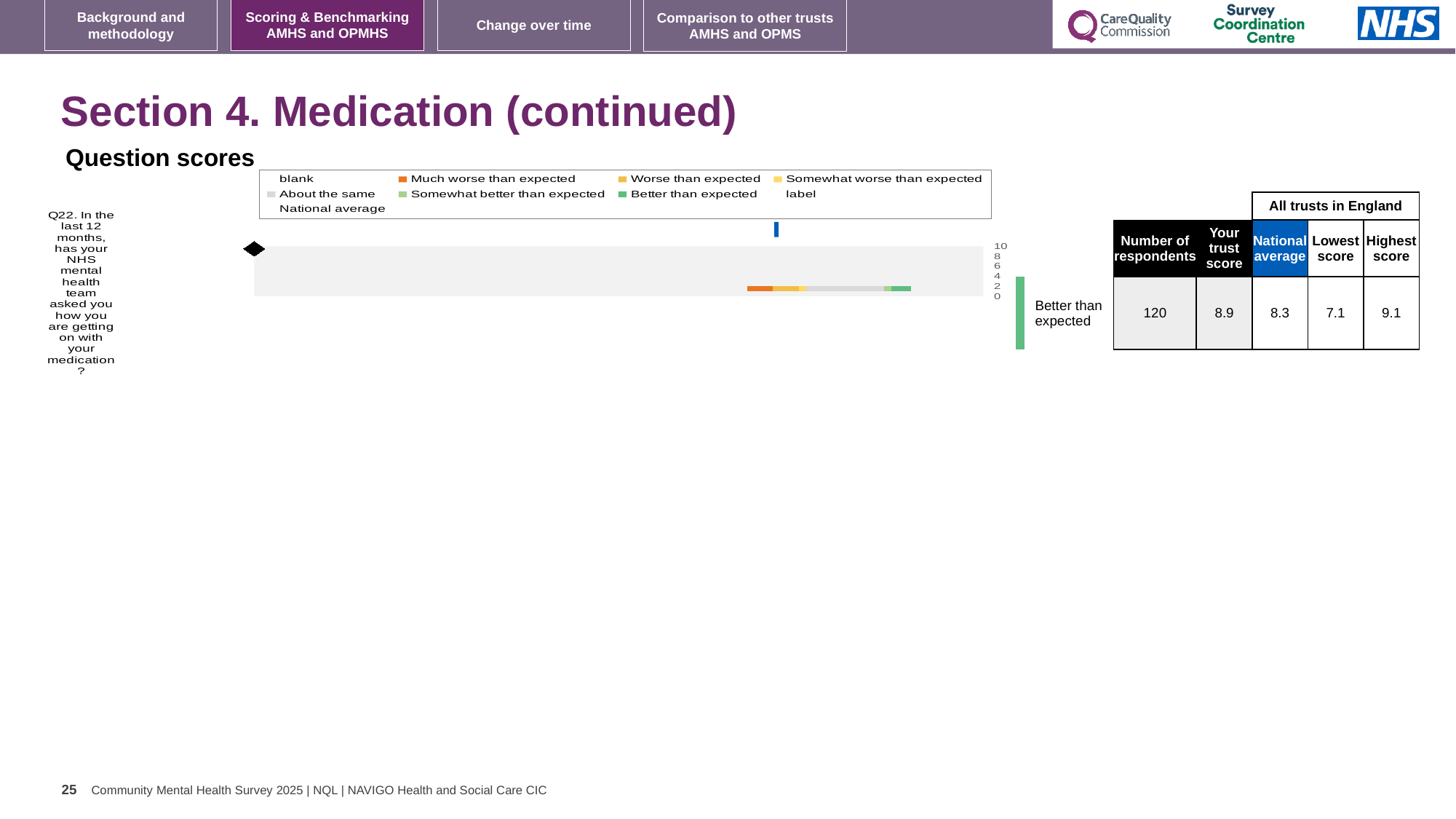
What is the national average score for Q22? 8.3 Which legend entry in the Question scores chart is shown in orange? Much worse than expected What is the trust's score for Q22 in the Question scores chart? 8.9 Which legend entry in the Question scores chart is shown in dark green? Better than expected What is the highest score among all trusts in England for Q22? 9.1 What is the difference between the highest score and the lowest score for Q22? 2.0 How many respondents answered Q22? 120 What kind of chart is shown under 'Question scores'? bar chart What is the lowest score among all trusts in England for Q22? 7.1 Which is larger for Q22, the trust's score or the national average? the trust's score How many questions are plotted in the Question scores chart? 1 Is the trust's score for Q22 greater or less than 8? greater